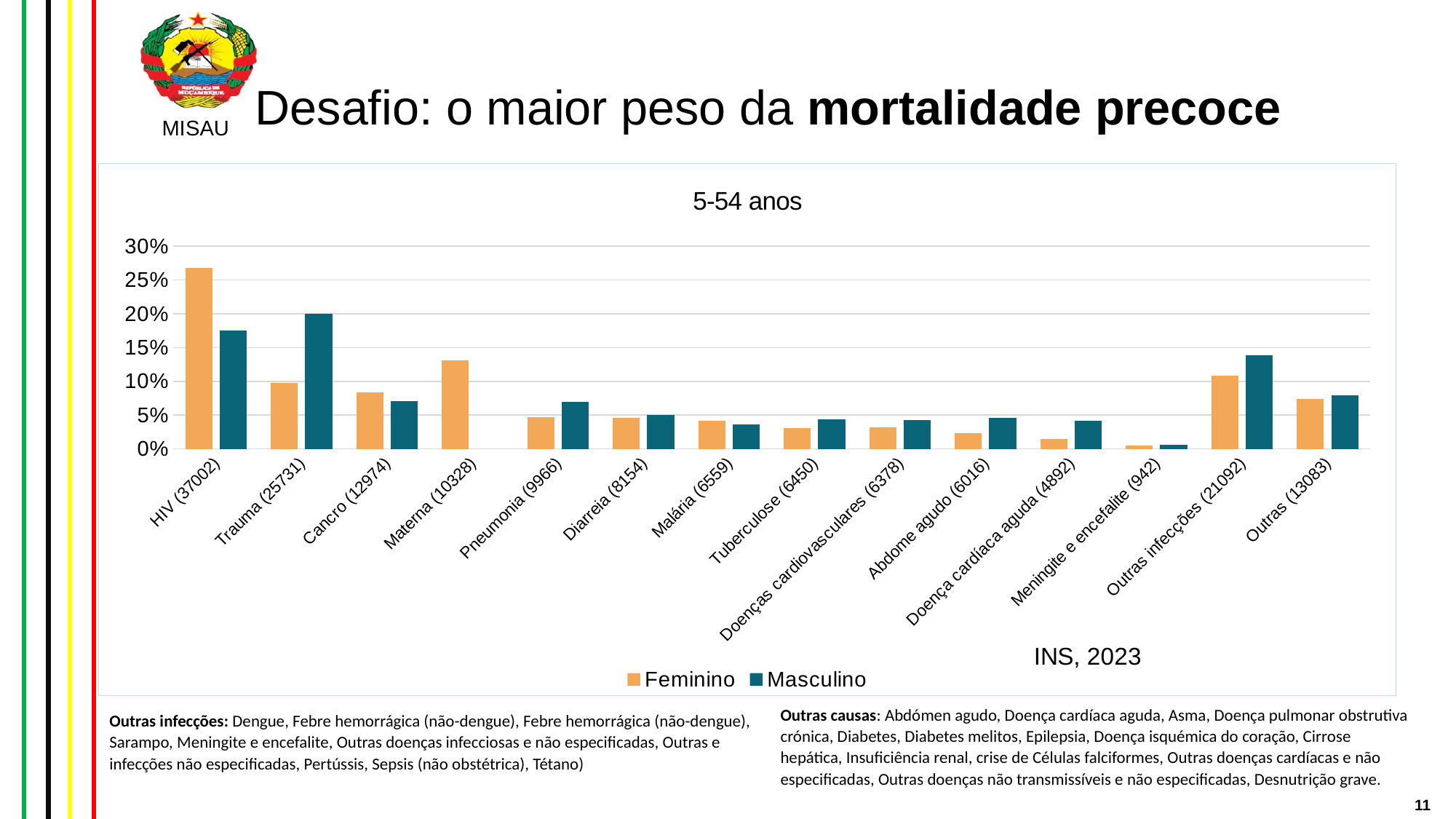
Is the Feminino value for Materna (10328) greater or less than 10%? greater Is the Feminino value for HIV (37002) greater or less than 25%? greater Which category has the highest Feminino value? HIV (37002) How many series does the legend list? 2 Which category has the highest Masculino value? Trauma (25731) How many categories are shown on the x axis of the chart? 14 What is the title of the chart? 5-54 anos What kind of chart is shown on the slide? bar chart Is the Masculino value for Trauma (25731) greater or less than 15%? greater For HIV (37002), which series has the larger value, Feminino or Masculino? Feminino For Trauma (25731), which series has the larger value, Feminino or Masculino? Masculino Which category has the lowest Feminino value? Meningite e encefalite (942)